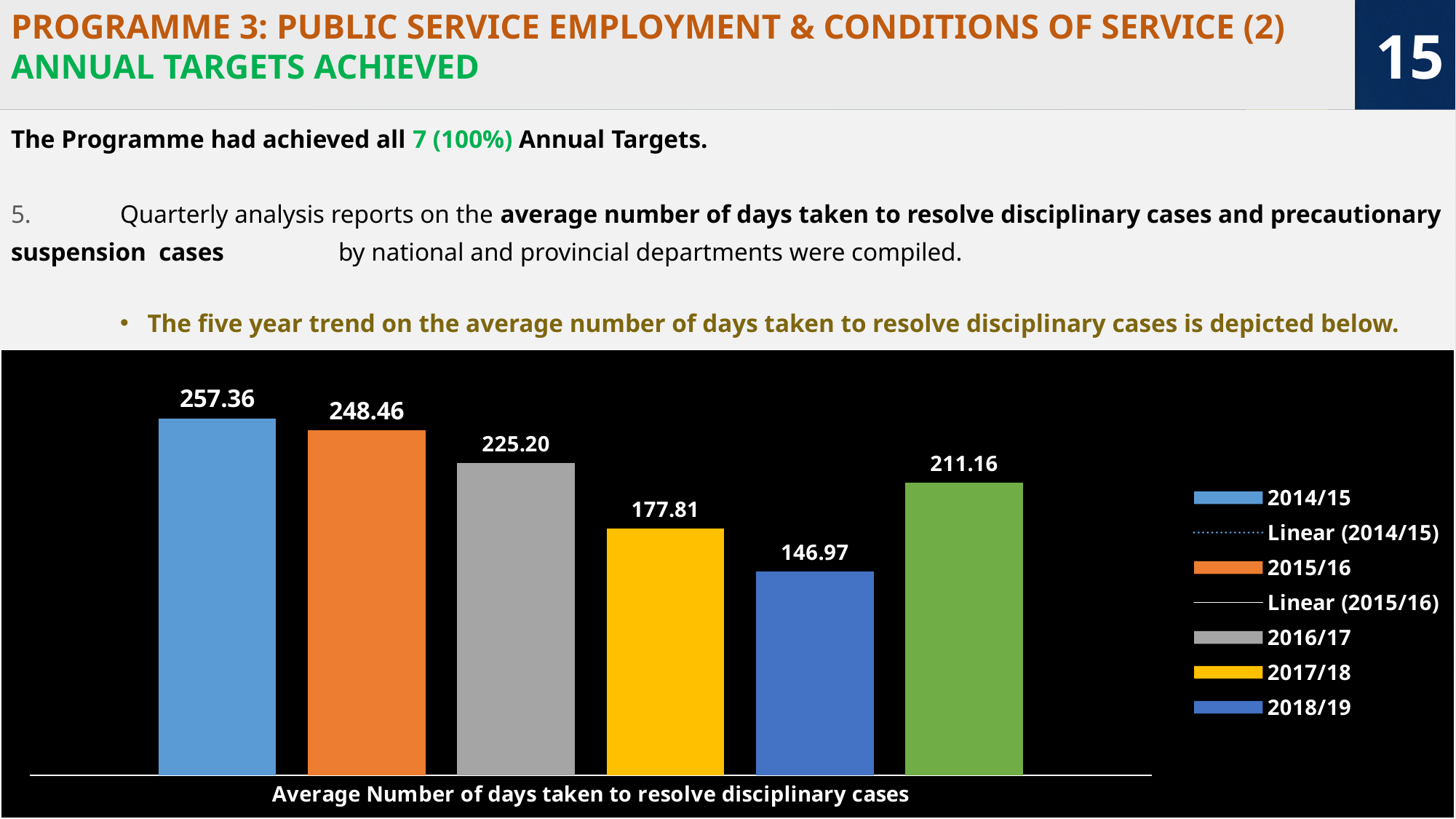
What value is shown for 2018/19 in the chart? 146.97 Which year has the lowest average number of days taken to resolve disciplinary cases? 2018/19 What is the difference between the values for 2014/15 and 2015/16? 8.90 How many entries does the chart legend list? 7 What is the average number of days taken to resolve disciplinary cases for 2014/15? 257.36 How many bars are plotted in the chart? 6 Which is larger, the value for 2016/17 or the value for 2017/18? 2016/17 What value is shown for 2017/18 in the chart? 177.81 What kind of chart is shown on the slide? Bar chart What is the difference between the values for 2016/17 and 2018/19? 78.23 What value is labelled on the green bar at the far right of the chart? 211.16 Which year has the highest average number of days taken to resolve disciplinary cases? 2014/15